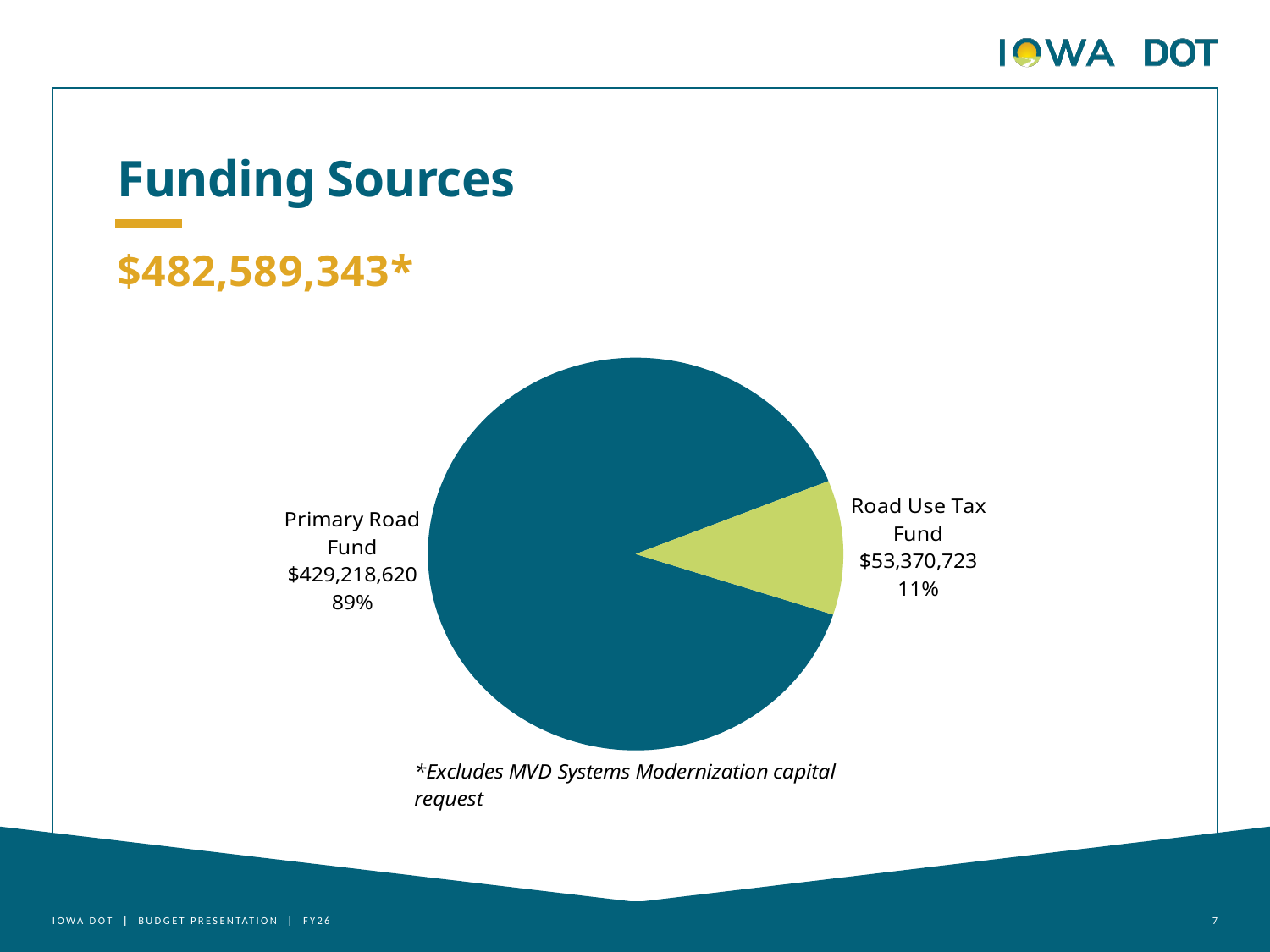
What is the value for the Road Use Tax Fund? $53,370,723 What share of the pie does the Road Use Tax Fund represent? 11% What kind of chart is shown on the slide? pie chart What is the value for the Primary Road Fund? $429,218,620 What is the difference between the Primary Road Fund and the Road Use Tax Fund? $375,847,897 What colour is the Road Use Tax Fund slice? light green How many slices does the pie chart have? 2 What is the total of the two funding sources shown? $482,589,343 Which funding source is the largest? Primary Road Fund What share of the pie does the Primary Road Fund represent? 89% Which funding source is the smallest? Road Use Tax Fund Which is larger, the Road Use Tax Fund or the Primary Road Fund? Primary Road Fund